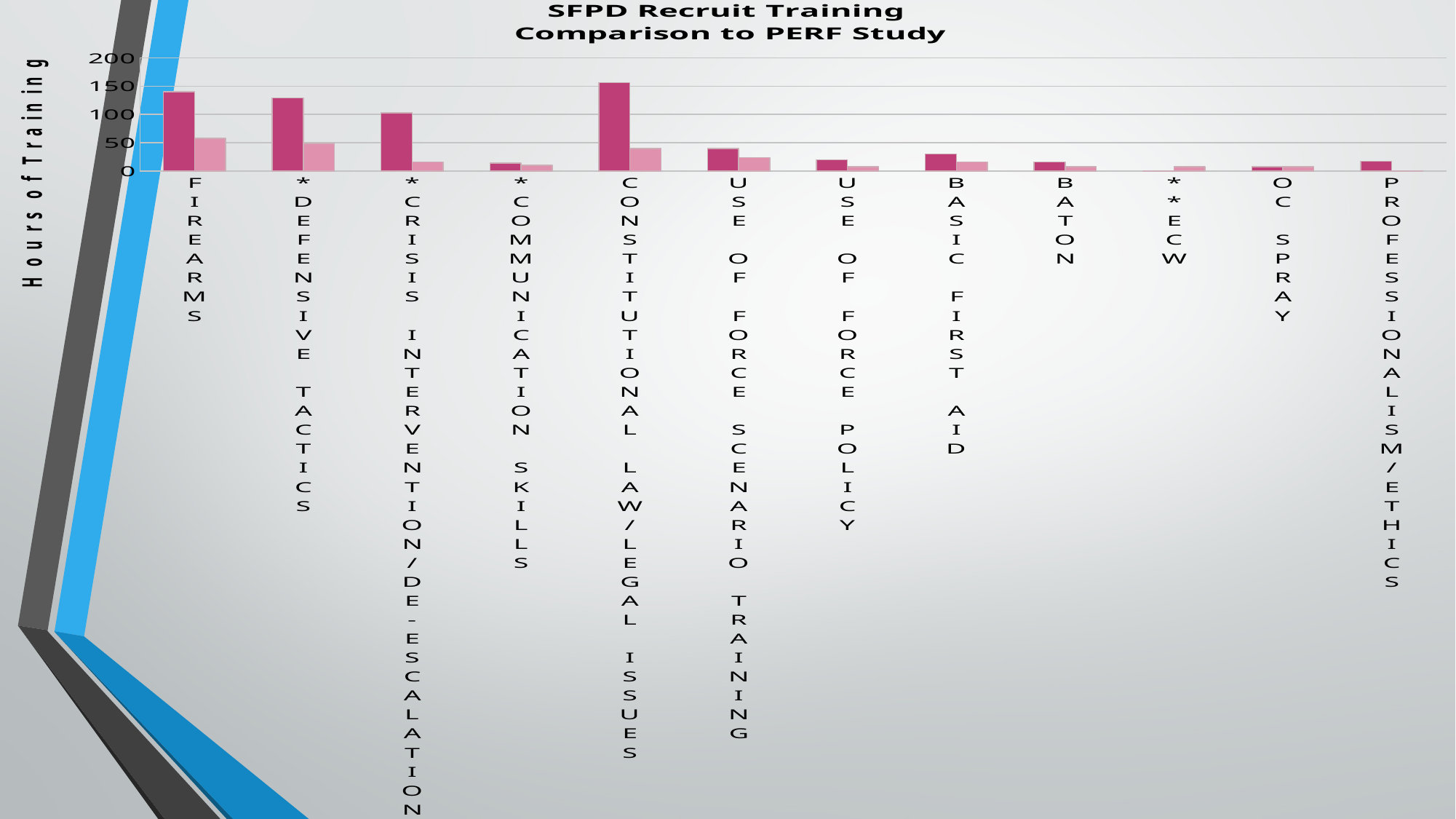
Is the dark pink bar for Firearms greater or less than 100? greater Is the dark pink bar for *Defensive Tactics greater or less than 100? greater Which category has the tallest dark pink bar? Constitutional Law/Legal Issues Which is larger for Firearms: the dark pink bar or the light pink bar? The dark pink bar What is the label on the vertical axis of the chart? Hours of Training What is the title of the chart? SFPD Recruit Training Comparison to PERF Study Which category has the smallest dark pink bar? **ECW Is the dark pink bar for *Communication Skills greater or less than 50? less Which category has the larger dark pink bar: Firearms or Constitutional Law/Legal Issues? Constitutional Law/Legal Issues What kind of chart is shown on the slide? Bar chart How many training categories are shown along the x axis? 12